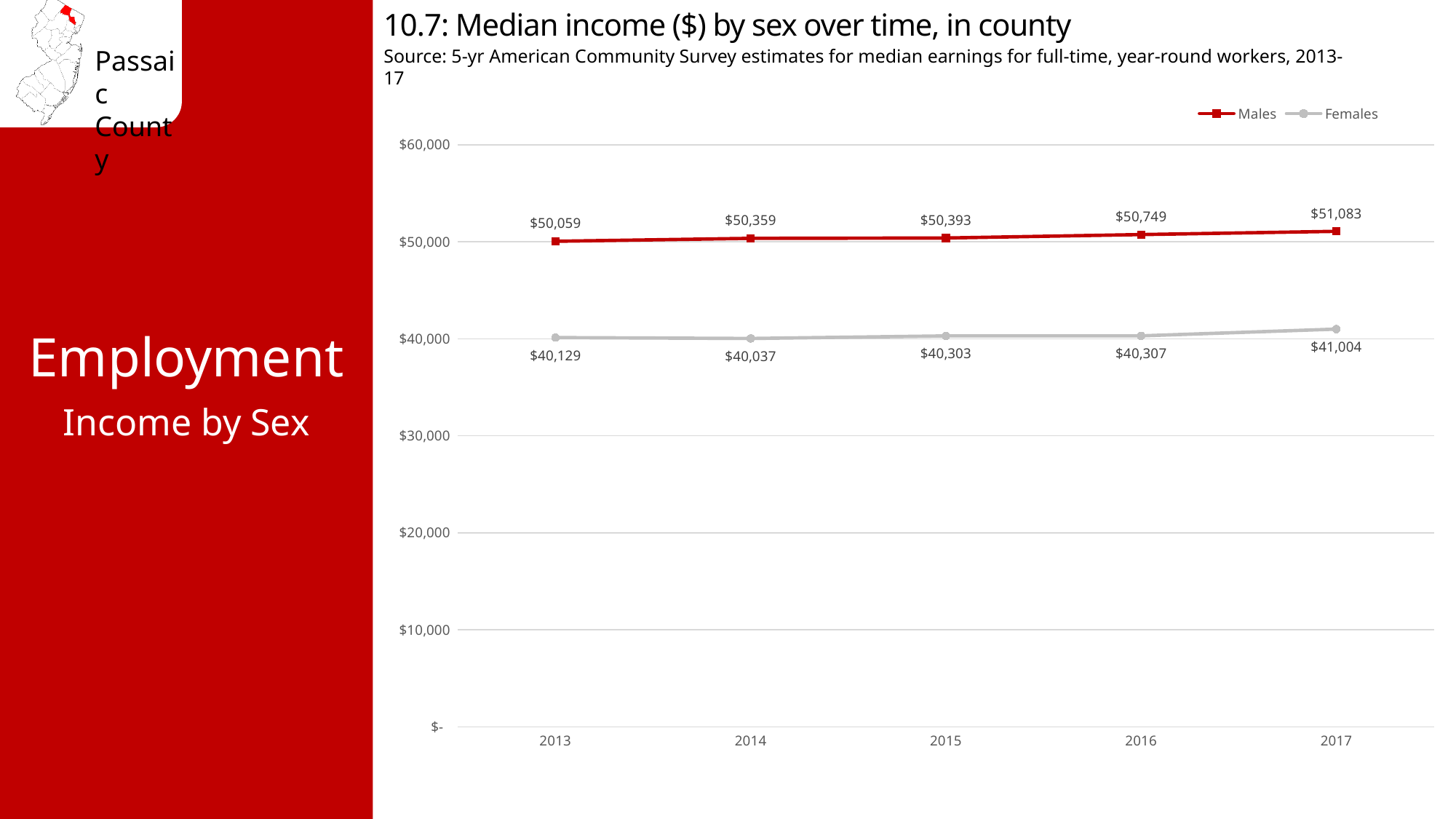
In which year was the median income for Females lowest? 2014 Does the median income for Males rise or fall from 2013 to 2017? Rise What kind of chart is shown on the slide? Line chart Which was higher in 2016, the median income for Males or for Females? Males What is the difference between the Males and Females median income in 2013? $9,930 What was the median income for Females in 2017? $41,004 How many years are shown on the x axis? 5 What was the median income for Males in 2015? $50,393 In which year was the median income for Males highest? 2017 How many series does the legend list? 2 By how much did the Males median income increase from 2013 to 2017? $1,024 What was the median income for Females in 2014? $40,037